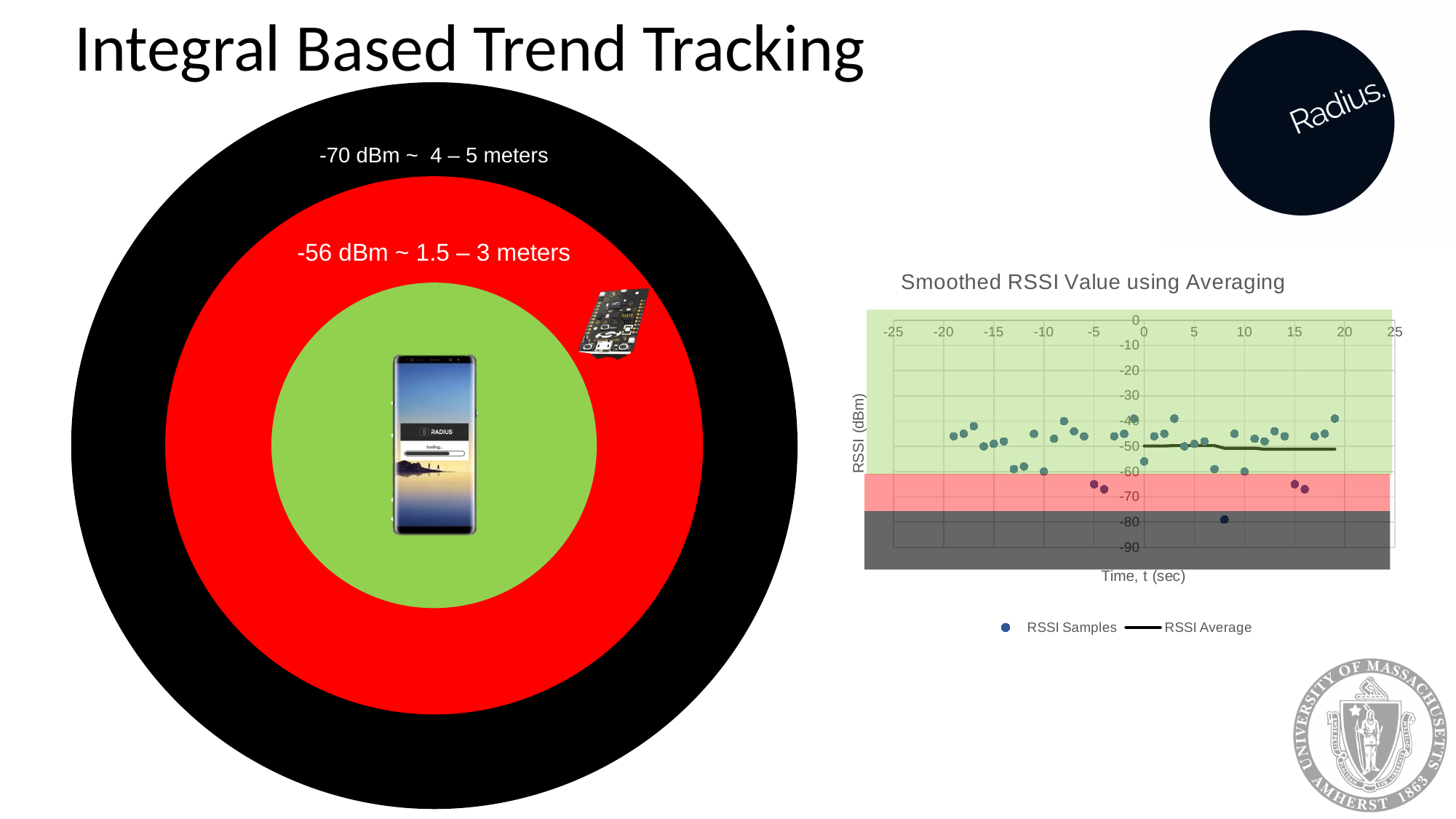
What kind of chart is "Smoothed RSSI Value using Averaging"? scatter chart How many series does the legend of the "Smoothed RSSI Value using Averaging" chart list? 2 In the "Smoothed RSSI Value using Averaging" chart, is the RSSI Average line greater or less than -60? greater In the "Smoothed RSSI Value using Averaging" chart, is the lowest RSSI sample value greater or less than -70? less In the "Smoothed RSSI Value using Averaging" chart, is the highest RSSI sample value greater or less than -50? greater What are the two series named in the legend of the "Smoothed RSSI Value using Averaging" chart? RSSI Samples and RSSI Average What is the title of the chart on the slide? Smoothed RSSI Value using Averaging